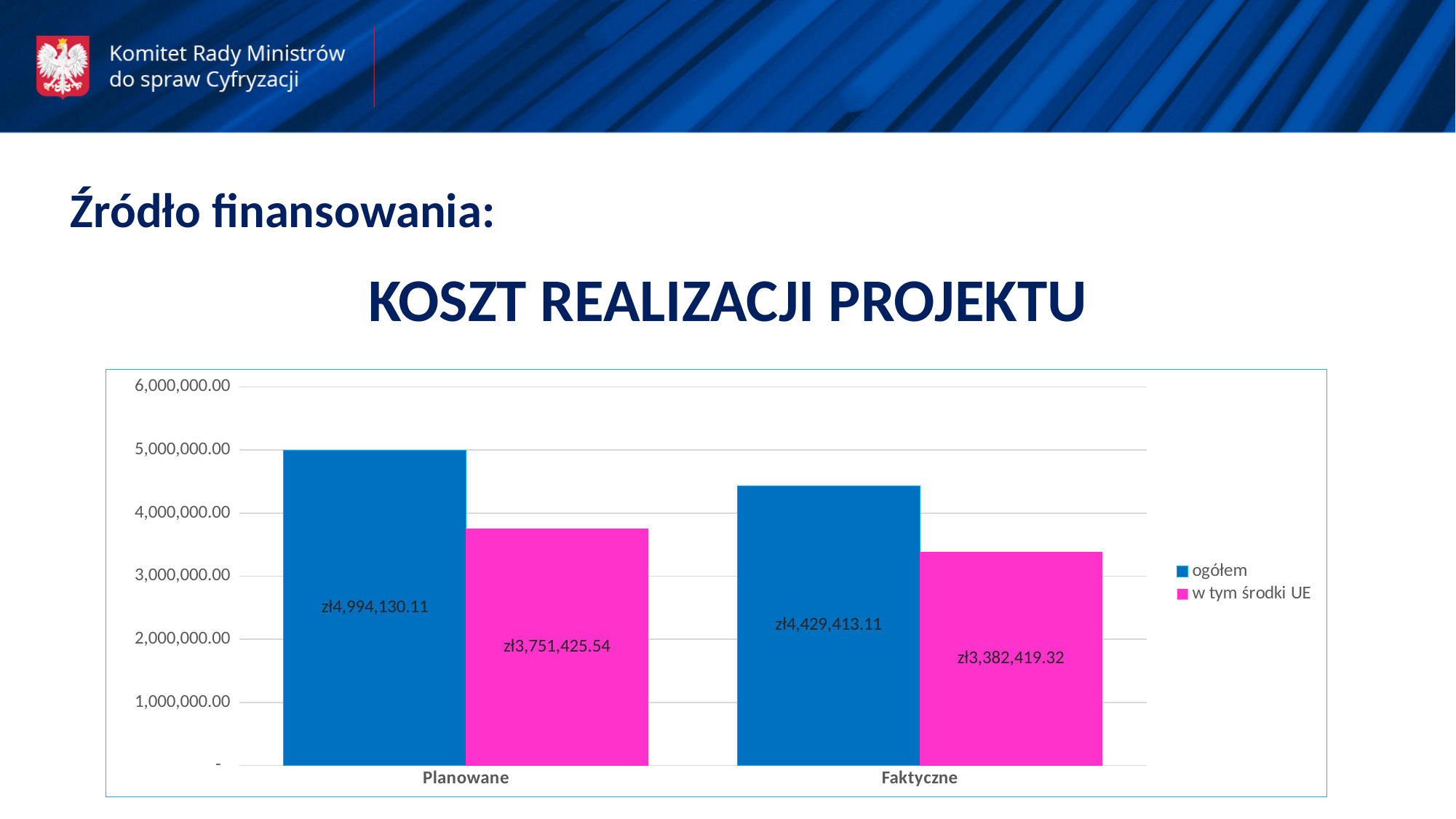
What is the value of "ogółem" for Planowane? zł4,994,130.11 Which is larger: "w tym środki UE" for Planowane or "w tym środki UE" for Faktyczne? Planowane What is the value of "w tym środki UE" for Faktyczne? zł3,382,419.32 What is the value of "ogółem" for Faktyczne? zł4,429,413.11 How many categories are shown on the x axis? 2 How many series does the legend list? 2 Which bar in the chart has the lowest value? w tym środki UE for Faktyczne What is the difference between the "ogółem" values for Planowane and Faktyczne? zł564,717.00 What is the difference between "ogółem" and "w tym środki UE" for Faktyczne? zł1,046,993.79 What is the value of "w tym środki UE" for Planowane? zł3,751,425.54 What type of chart is shown on the slide? Bar chart Which bar in the chart has the highest value? ogółem for Planowane